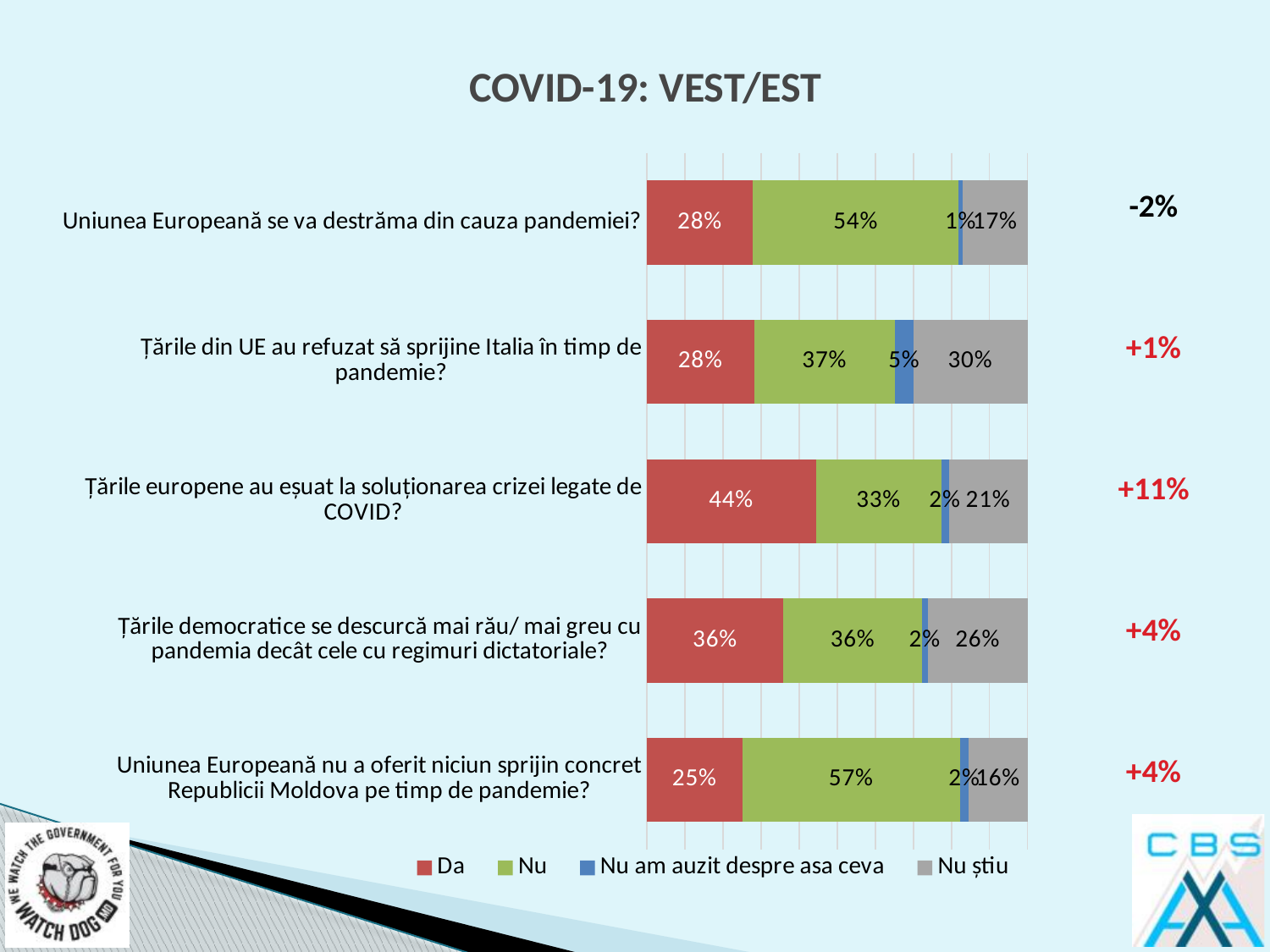
What kind of chart is shown on the slide? Stacked bar chart For 'Țările din UE au refuzat să sprijine Italia în timp de pandemie?', which is larger: the 'Nu' share or the 'Nu știu' share? Nu What is the title of the chart slide? COVID-19: VEST/EST How many statements (categories) are plotted in the chart? 5 Which statement has the highest 'Da' share? Țările europene au eșuat la soluționarea crizei legate de COVID? Which statement has the lowest 'Da' share? Uniunea Europeană nu a oferit niciun sprijin concret Republicii Moldova pe timp de pandemie? What is the 'Nu' value for 'Uniunea Europeană nu a oferit niciun sprijin concret Republicii Moldova pe timp de pandemie?' 57% How many series does the legend list? 4 For 'Uniunea Europeană se va destrăma din cauza pandemiei?', how much larger is the 'Nu' share than the 'Da' share? 26 percentage points What is the 'Da' value for 'Țările europene au eșuat la soluționarea crizei legate de COVID?' 44% What is the 'Nu știu' value for 'Țările din UE au refuzat să sprijine Italia în timp de pandemie?' 30% What is the total of the stacked bar for 'Țările democratice se descurcă mai rău/ mai greu cu pandemia decât cele cu regimuri dictatoriale?' 100%